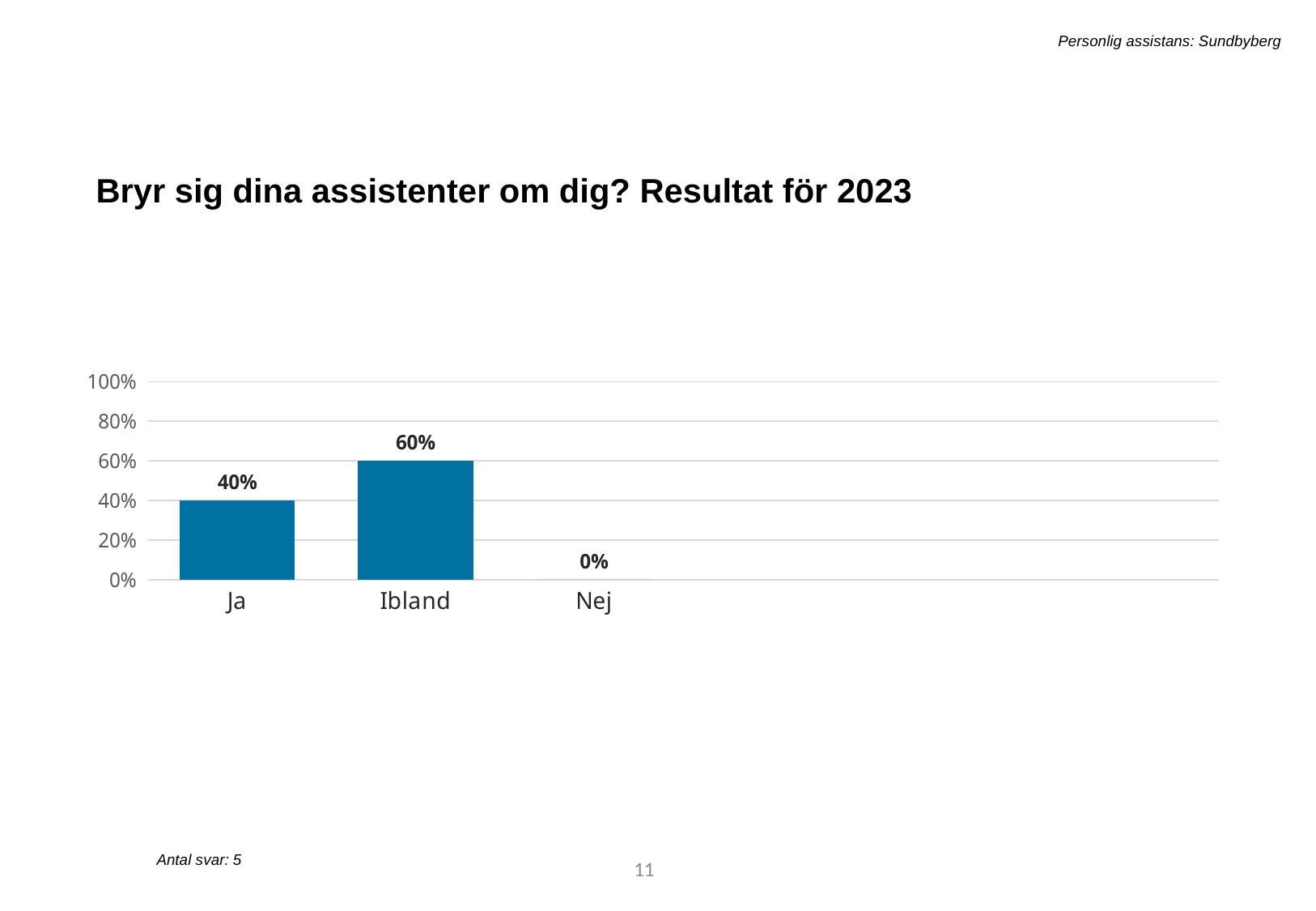
Which category has the highest value? Ibland What kind of chart is shown on the slide? bar chart What is the highest value shown on the y axis? 100% Which is larger, the value for Ja or the value for Ibland? Ibland What is the value for Ibland? 60% How many categories are shown on the x axis? 3 What is the value for Nej? 0% Is the value for Ibland greater or less than 50%? greater What is the difference between the values for Ibland and Ja? 20% What is the value for Ja? 40% Which category has the lowest value? Nej What is the title of the slide? Bryr sig dina assistenter om dig? Resultat för 2023